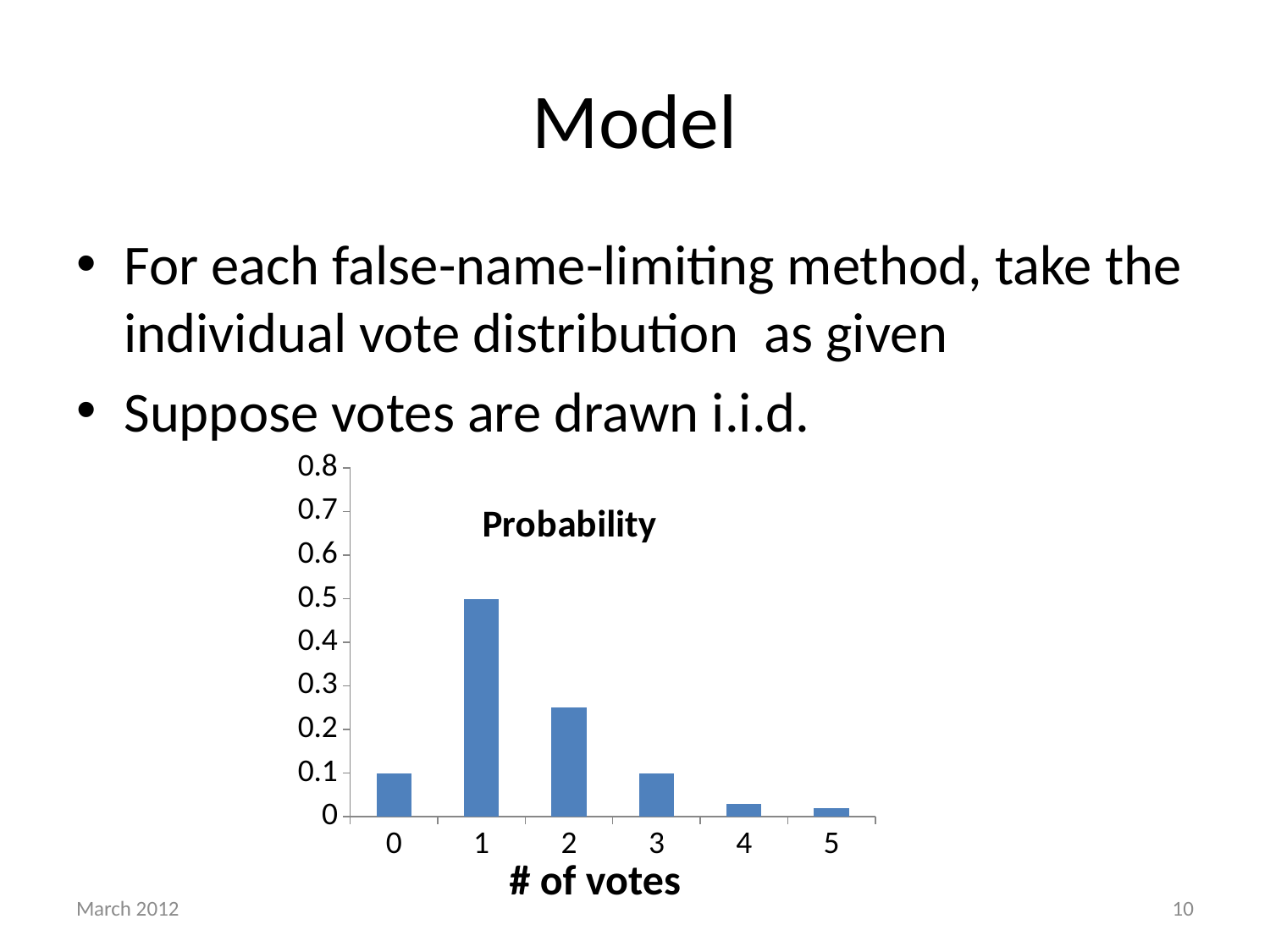
Is the probability for 4 votes greater or less than 0.1? less How many vote-count categories are shown on the x axis? 6 Which number of votes has the highest probability? 1 What kind of chart is shown on the slide? Bar chart From 1 vote to 5 votes, do the probabilities rise or fall? Fall Is the probability for 5 votes greater or less than 0.1? less Which has a higher probability, 1 vote or 2 votes? 1 vote Is the probability for 2 votes greater or less than 0.2? greater What is the probability for 1 vote? 0.5 What is the probability for 0 votes? 0.1 What is the difference between the probability for 1 vote and the probability for 0 votes? 0.4 What is the probability for 3 votes? 0.1